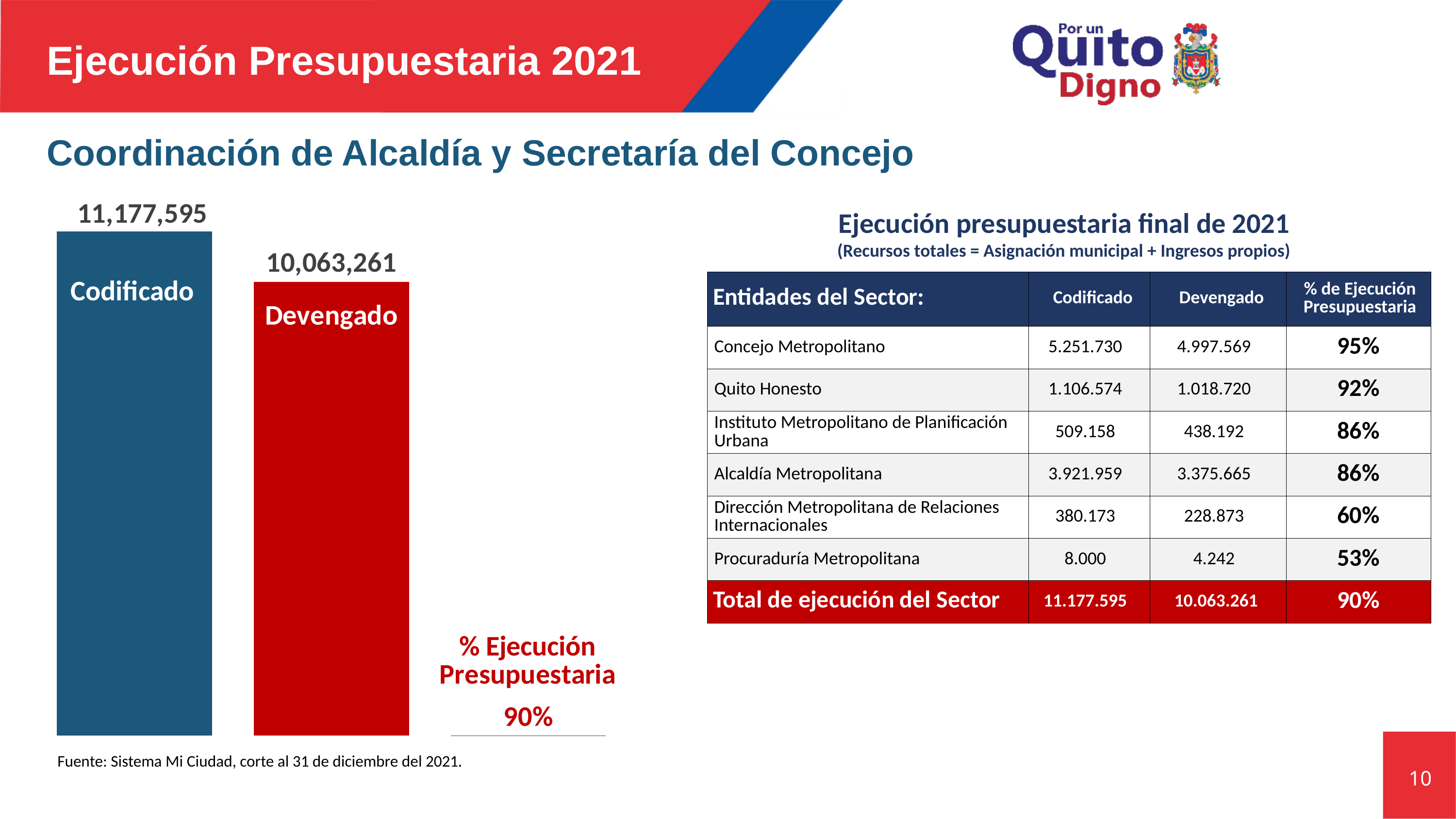
What is the value of the Codificado bar? 11,177,595 Which bar has the highest value? Codificado What is the difference between the Codificado and Devengado values? 1,114,334 Which bar has the lowest value? Devengado What colour is the Codificado bar? Blue What % Ejecución Presupuestaria is shown next to the bar chart? 90% Do the values fall from the Codificado bar to the Devengado bar? Yes, they fall How many bars are shown in the chart? 2 Which bar is taller, Codificado or Devengado? Codificado What colour is the Devengado bar? Red What kind of chart is shown on the left of the slide? Bar chart What is the value of the Devengado bar? 10,063,261